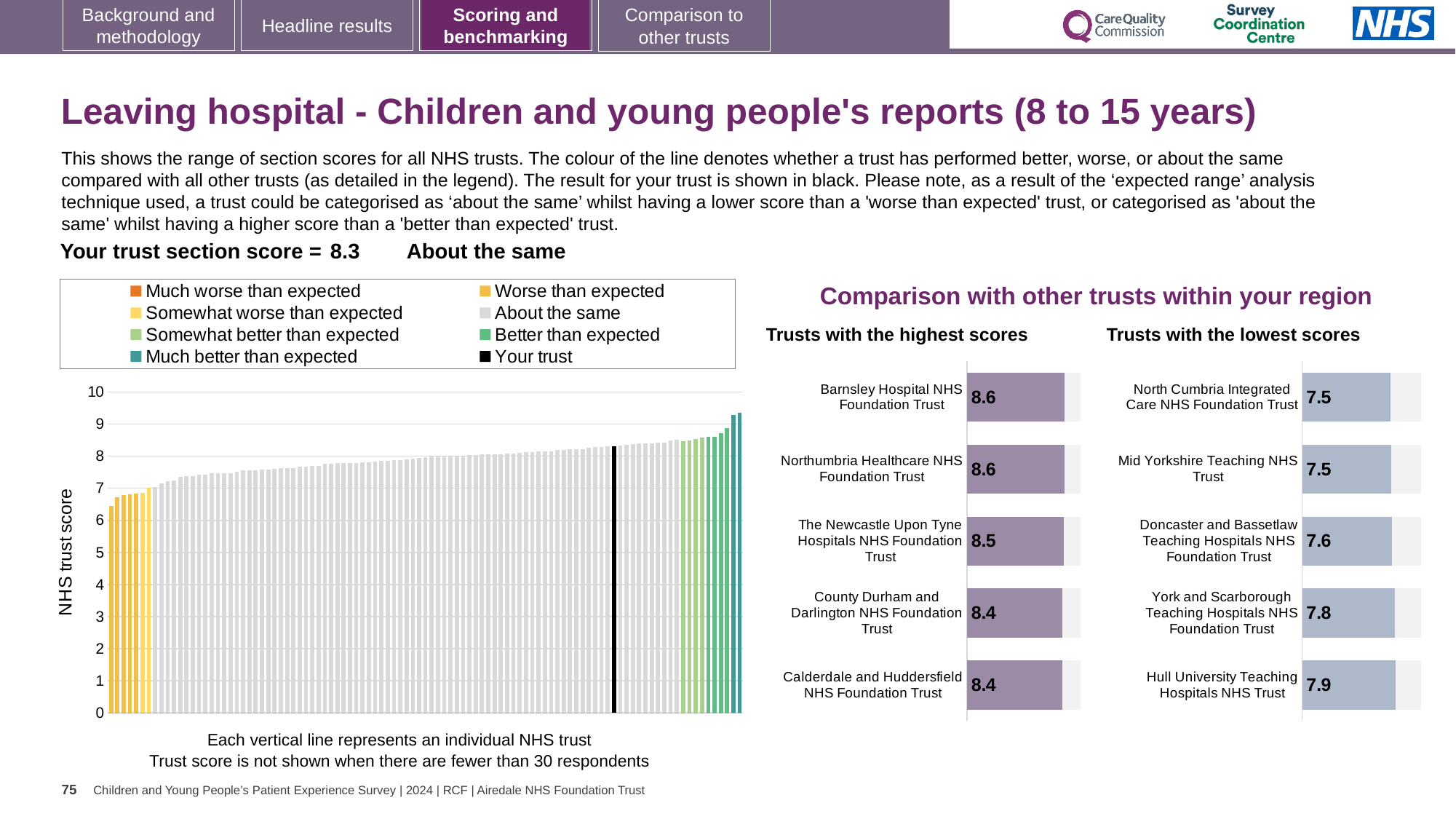
In the 'Trusts with the highest scores' chart, what is the difference between the scores of Barnsley Hospital NHS Foundation Trust and Calderdale and Huddersfield NHS Foundation Trust? 0.2 In the large chart on the left, do the trust scores rise or fall from left to right? Rise In the large chart on the left, is the value of the lowest bar greater or less than 7? less In the 'Trusts with the lowest scores' chart, what is the difference between the scores of Hull University Teaching Hospitals NHS Trust and North Cumbria Integrated Care NHS Foundation Trust? 0.4 In the 'Trusts with the lowest scores' chart, what is the score for York and Scarborough Teaching Hospitals NHS Foundation Trust? 7.8 What kind of chart is the large chart on the left showing NHS trust scores? Bar chart In the 'Trusts with the lowest scores' chart, which trust has the highest score? Hull University Teaching Hospitals NHS Trust In the 'Trusts with the highest scores' chart, what is the score for The Newcastle Upon Tyne Hospitals NHS Foundation Trust? 8.5 How many entries does the legend above the large chart on the left list? 8 What is the y-axis label of the large chart on the left? NHS trust score Which has the higher score: The Newcastle Upon Tyne Hospitals NHS Foundation Trust in the highest scores chart or Doncaster and Bassetlaw Teaching Hospitals NHS Foundation Trust in the lowest scores chart? The Newcastle Upon Tyne Hospitals NHS Foundation Trust How many trusts are listed in the 'Trusts with the highest scores' chart? 5